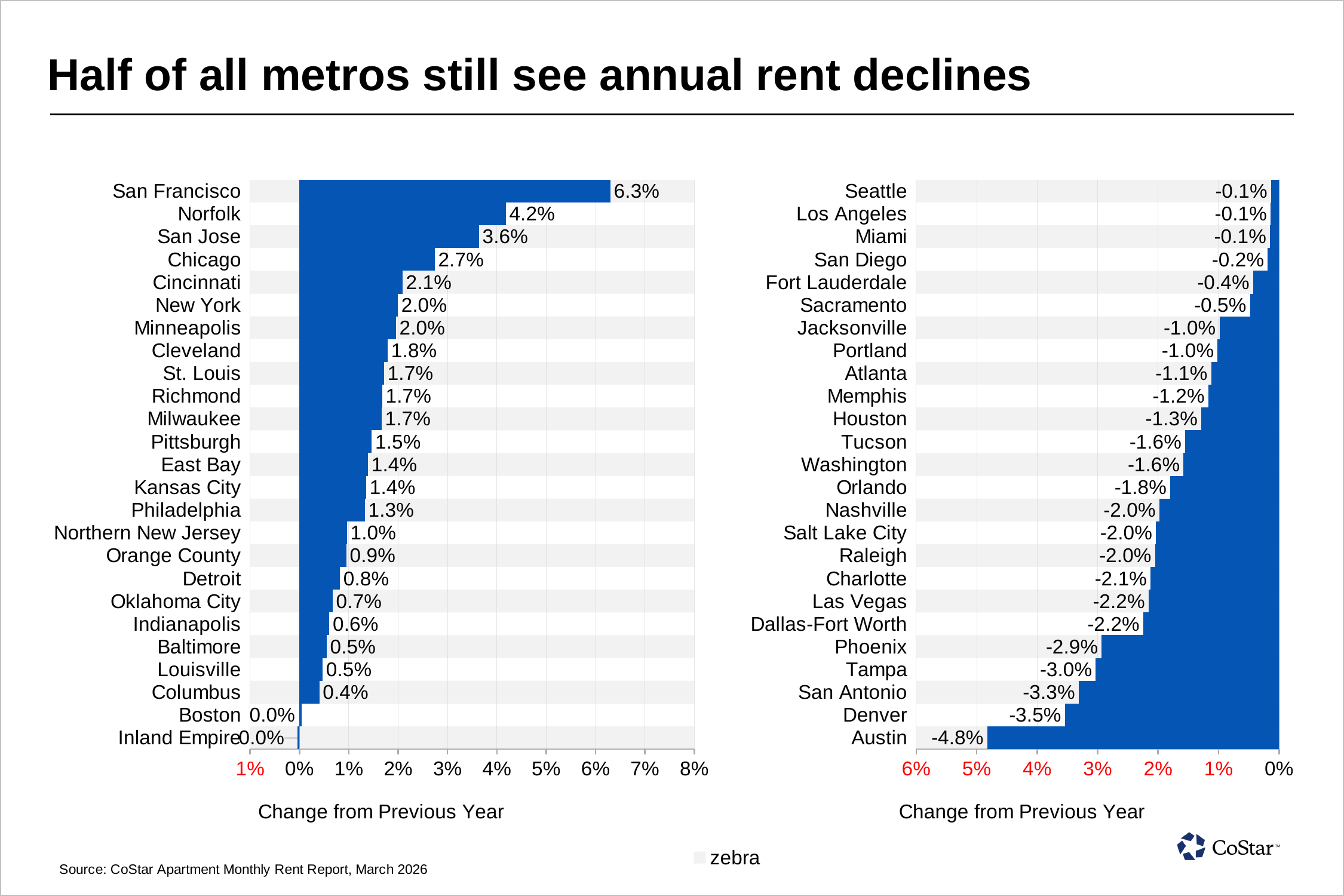
On the left chart, which metro has the highest change from previous year? San Francisco How many metros are shown on the left chart? 25 What is the x-axis title of the left chart? Change from Previous Year On the left chart, which is larger, the value for San Jose or the value for Cincinnati? San Jose On the left chart, what is the value for Chicago? 2.7% On the left chart, what is the difference between the values for San Francisco and Norfolk? 2.1% On the right chart, what is the change from previous year for Austin? -4.8% On the left chart, what is the change from previous year for San Francisco? 6.3% On the right chart, what is the value for Phoenix? -2.9% On the right chart, what is the difference between the values for Denver and Austin? 1.3% What kind of chart is the right chart? bar chart On the right chart, which metro has the lowest change from previous year? Austin